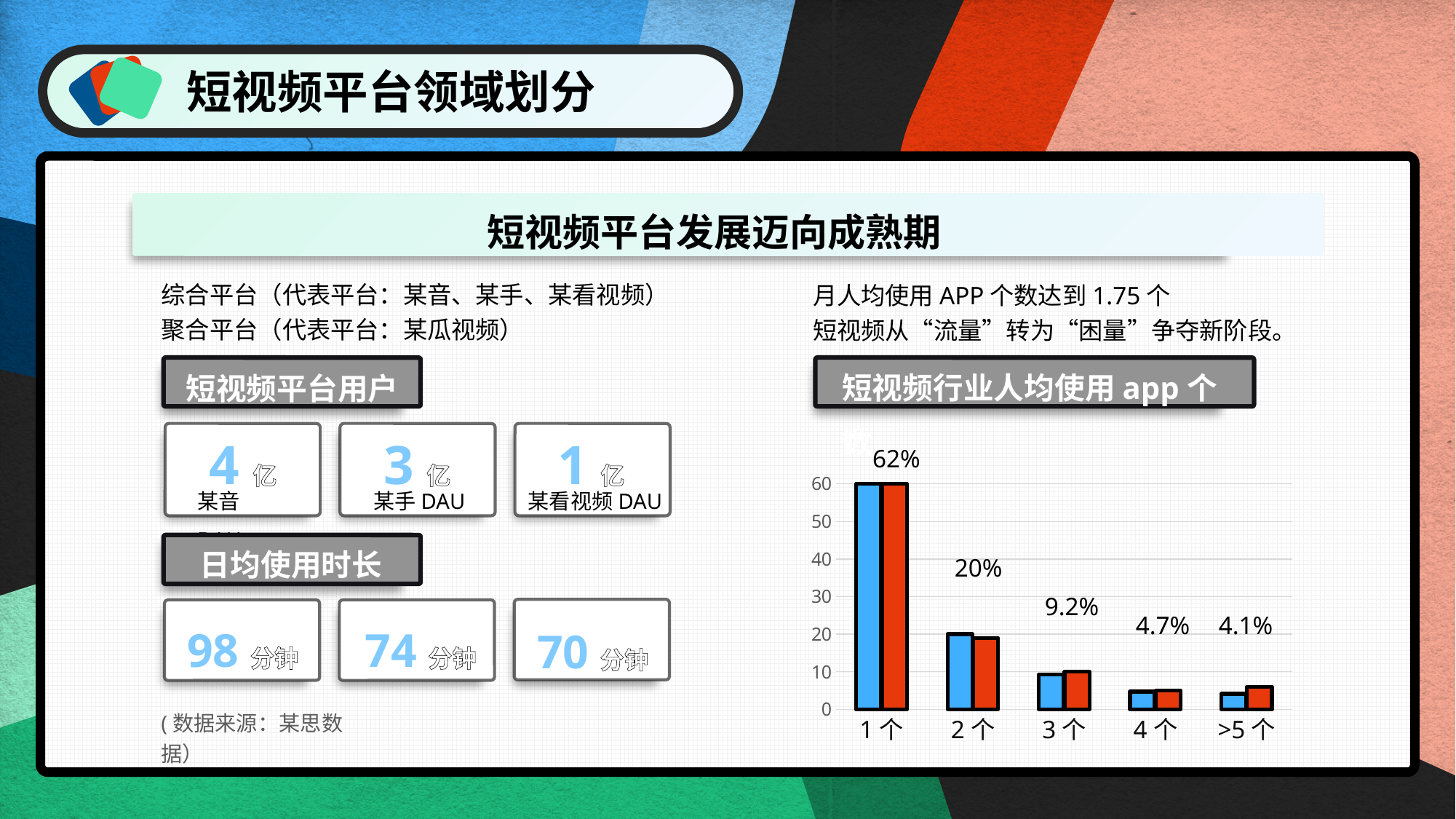
What data label is shown above the bars for the category 1 个? 62% What two colours are used for the bars in the chart? blue and red How many categories are shown on the x axis of the bar chart? 5 What data label is shown above the bars for the category 3 个? 9.2% What data label is shown above the bars for the category >5 个? 4.1% Do the bar values rise or fall from 1 个 to >5 个 along the x axis? fall What kind of chart is shown on the slide? bar chart What data label is shown above the bars for the category 2 个? 20% Is the value for 2 个 greater or less than 30? less What is the difference between the data labels for 1 个 and 2 个? 42% Which category has the highest bars in the chart? 1 个 Which category has the lowest bars in the chart? >5 个